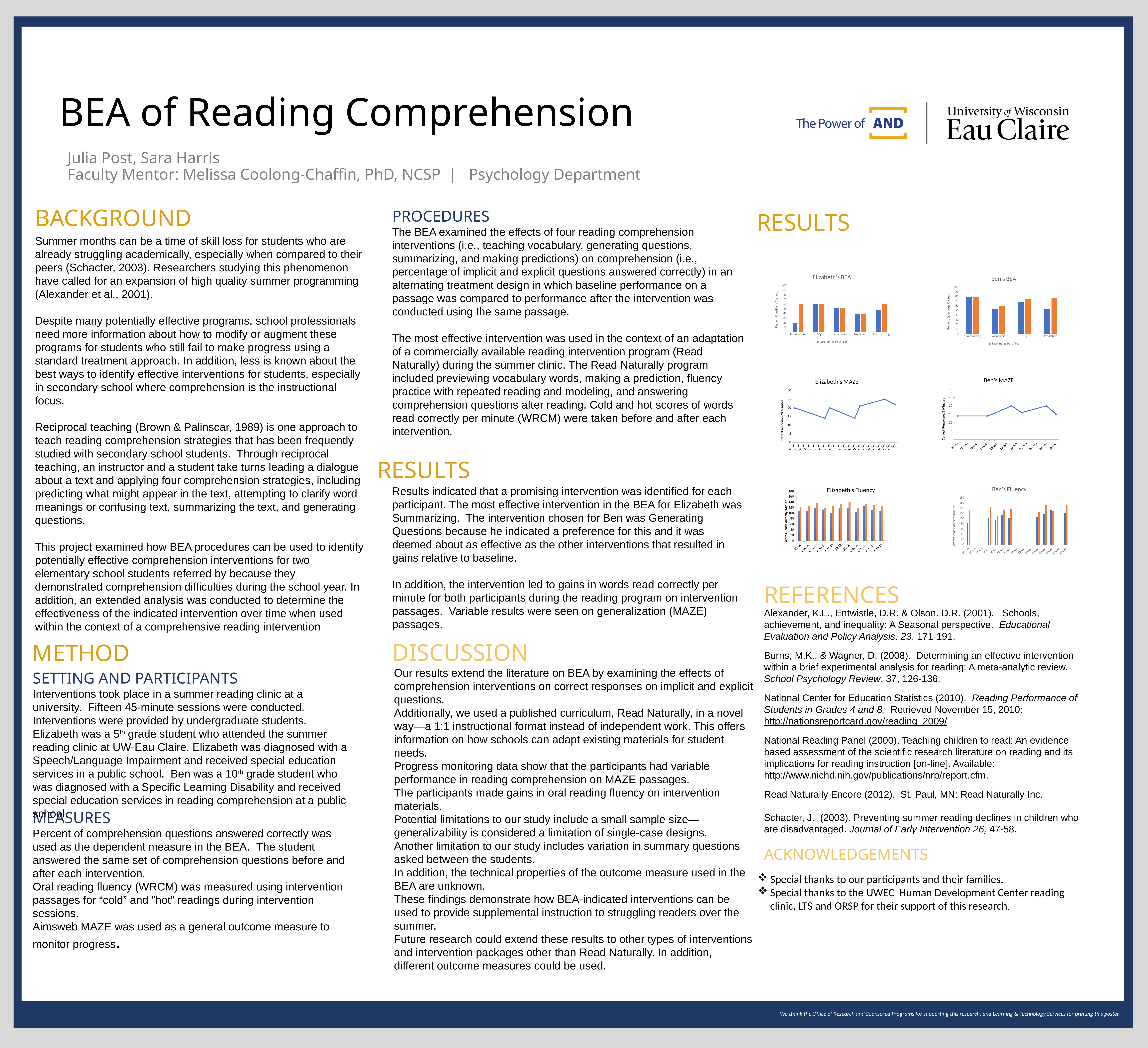
What are the two legend entries in "Elizabeth's BEA"? Baseline and Post Test How many categories are shown on the x axis of "Elizabeth's BEA"? 5 How many series does the legend of "Ben's BEA" list? 2 In "Ben's BEA", is the Baseline value for Summarizing greater or less than 60? greater In "Elizabeth's BEA", which category has the lowest Baseline value? Summarizing (the first category) What kind of chart is "Ben's Fluency"? bar chart What kind of chart is "Elizabeth's BEA"? bar chart In "Ben's BEA", which category has the highest Baseline value? Summarizing In "Elizabeth's BEA", is the Baseline value for the first Summarizing category greater or less than 40? less What kind of chart is "Elizabeth's MAZE"? line chart In "Ben's BEA", for Prediction, which is larger: the Baseline value or the Post Test value? Post Test How many categories are shown on the x axis of "Ben's BEA"? 4